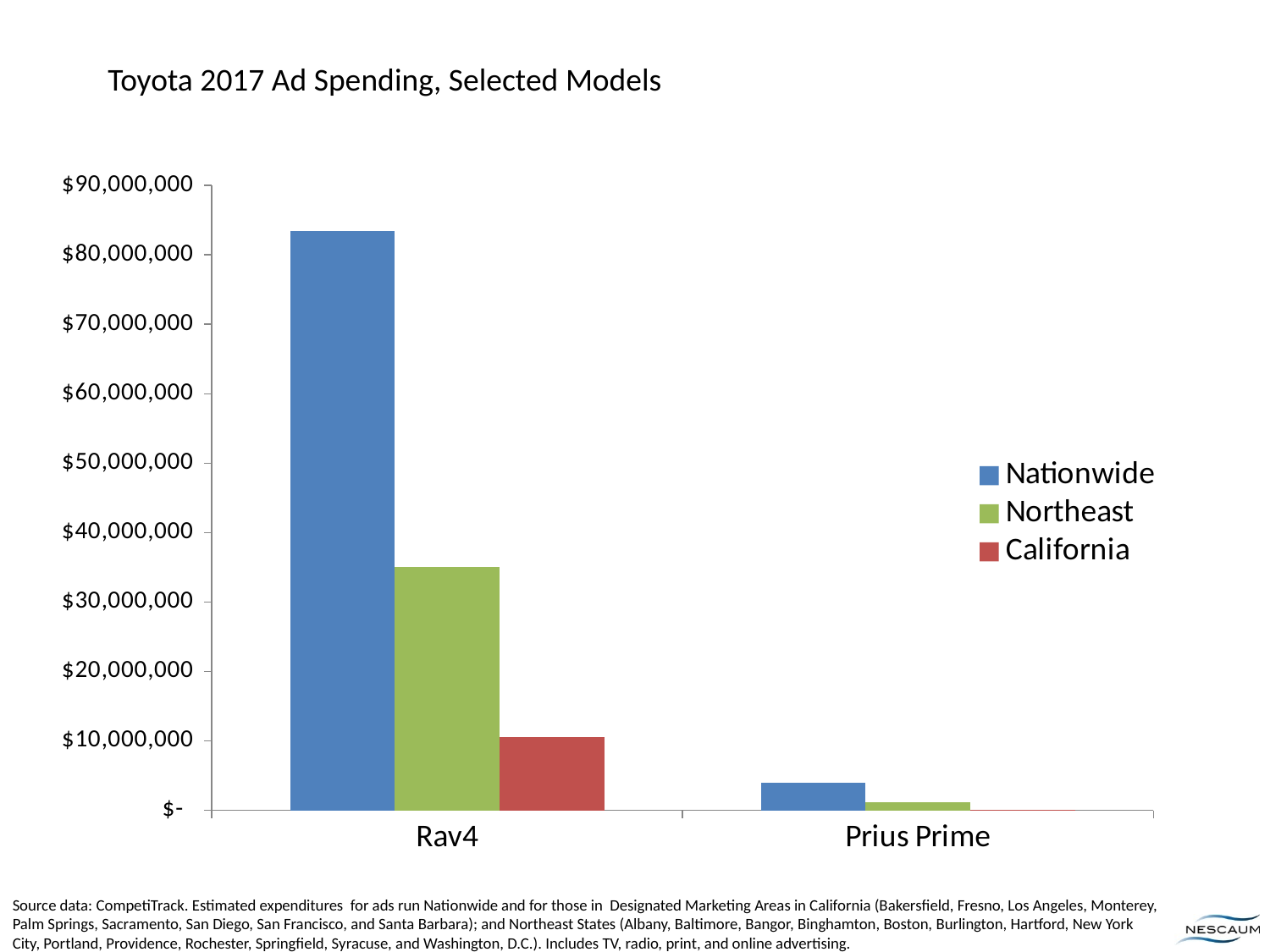
How many models (categories) are shown on the x axis? 2 Is the Nationwide ad spending for Rav4 greater or less than $80,000,000? greater What kind of chart is shown on the slide? Bar chart Is the California ad spending for Rav4 greater or less than $20,000,000? less Which colour represents the Northeast series in the legend? Green For Rav4, which is larger: Nationwide or Northeast ad spending? Nationwide What is the title of the chart? Toyota 2017 Ad Spending, Selected Models How many series does the legend list? 3 Which model has the higher Nationwide ad spending? Rav4 For Rav4, which region has the lowest ad spending? California Is the Northeast ad spending for Rav4 greater or less than $40,000,000? less